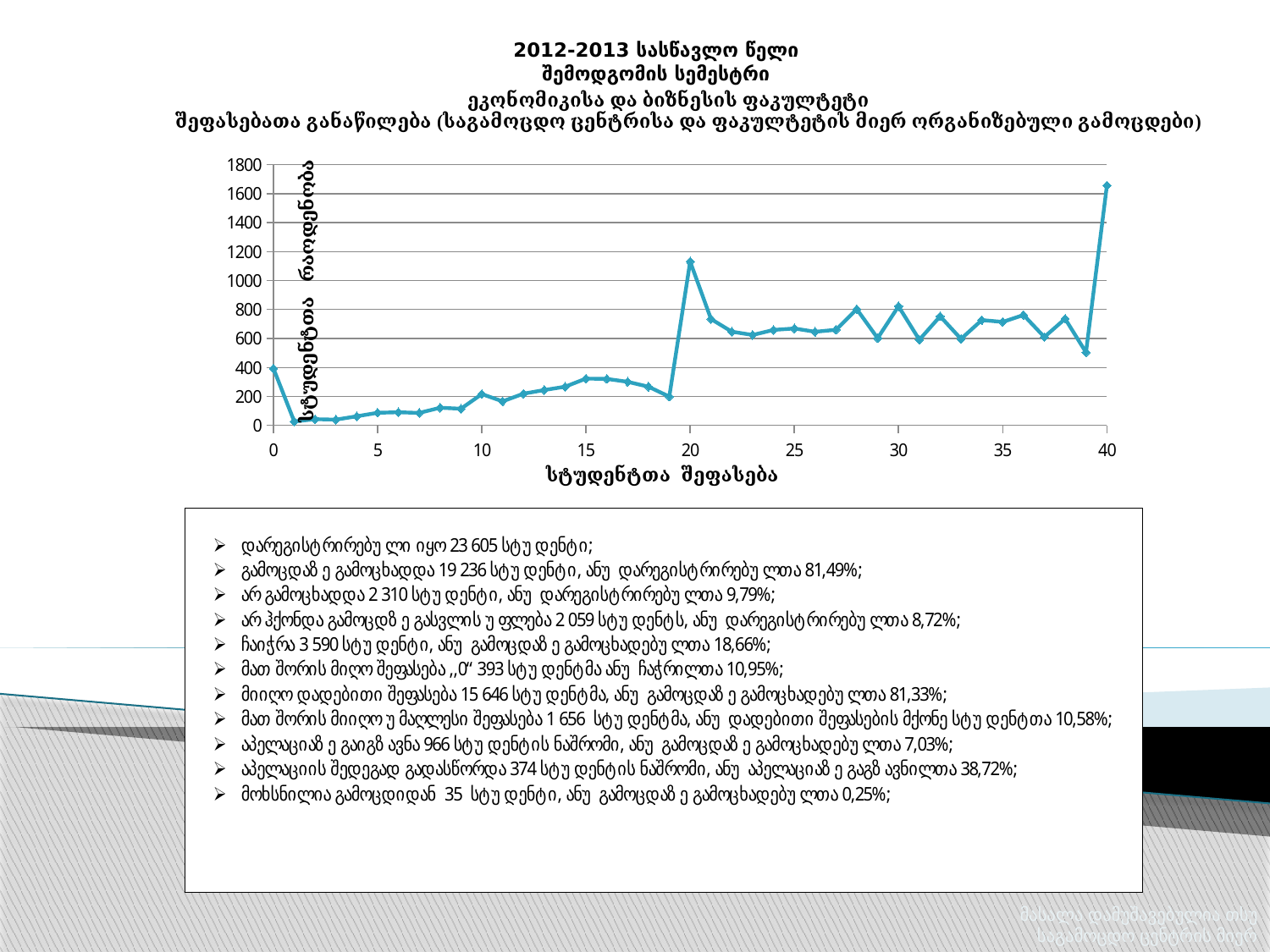
Is the value at x = 0 greater or less than 600? less Which has the larger value, the point at x = 20 or the point at x = 30? x = 20 Is the value at x = 30 greater or less than 600? greater Which has the larger value, the point at x = 0 or the point at x = 10? x = 0 At which x-axis value does the line reach its highest point? 40 Do the values rise or fall along the x axis between x = 20 and x = 23? fall What is the label of the y axis of the chart? სტუდენტთა რაოდენობა What kind of chart is shown on the slide? line chart Is the value at x = 40 greater or less than 1400? greater What is the label of the x axis of the chart? სტუდენტთა შეფასება